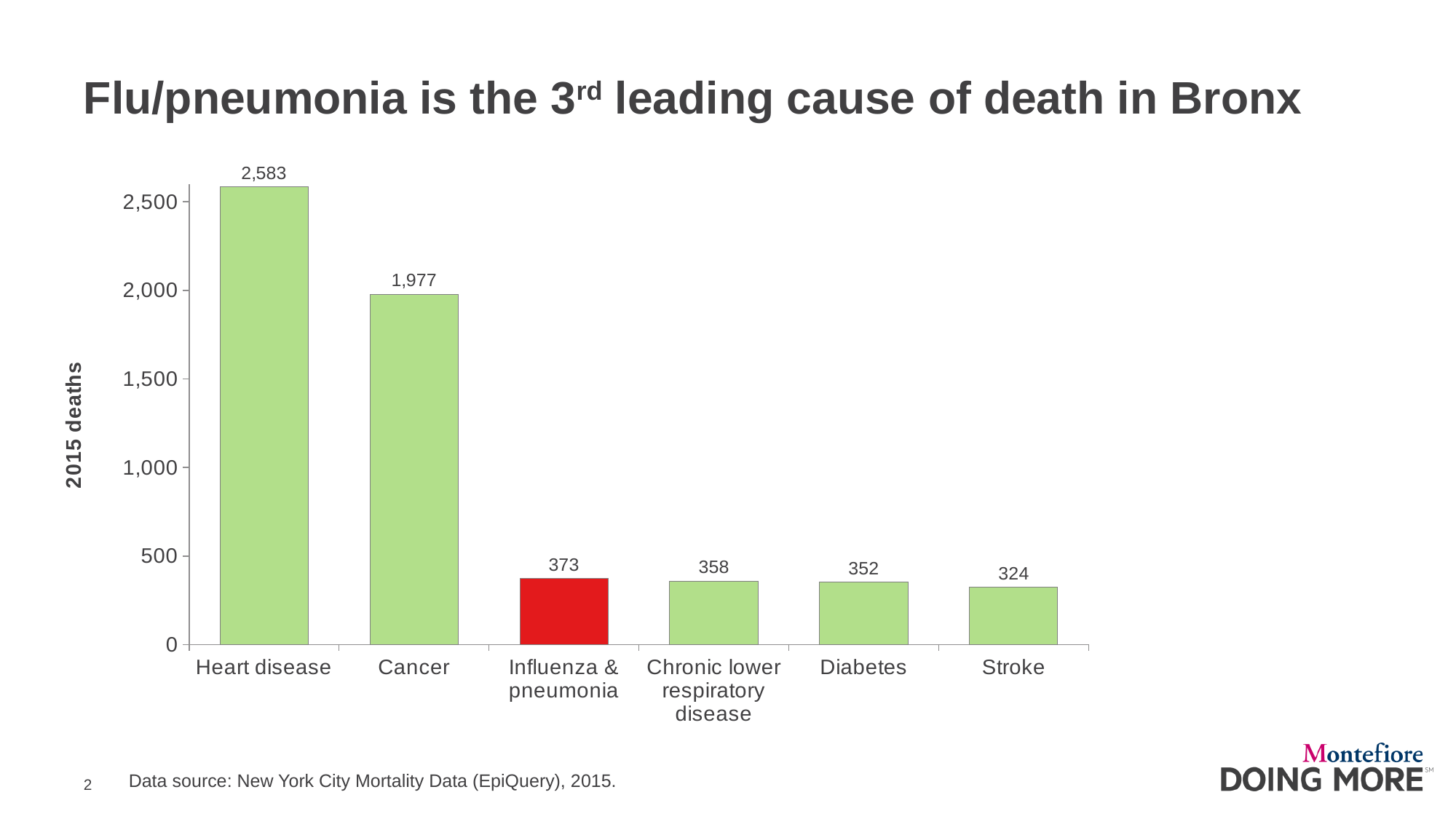
Which bar is coloured red? Influenza & pneumonia What is the value for Stroke? 324 What is the difference between the values for Heart disease and Cancer? 606 What is the value for Influenza & pneumonia? 373 How many 2015 deaths are shown for Heart disease? 2,583 What is the difference between the values for Influenza & pneumonia and Diabetes? 21 How many causes of death are shown on the chart? 6 Which cause of death has the lowest number of 2015 deaths? Stroke Is the value for Cancer greater or less than 1,500? greater Which cause of death has the highest number of 2015 deaths? Heart disease What kind of chart is shown on the slide? Bar chart Which is larger, the value for Cancer or the value for Chronic lower respiratory disease? Cancer